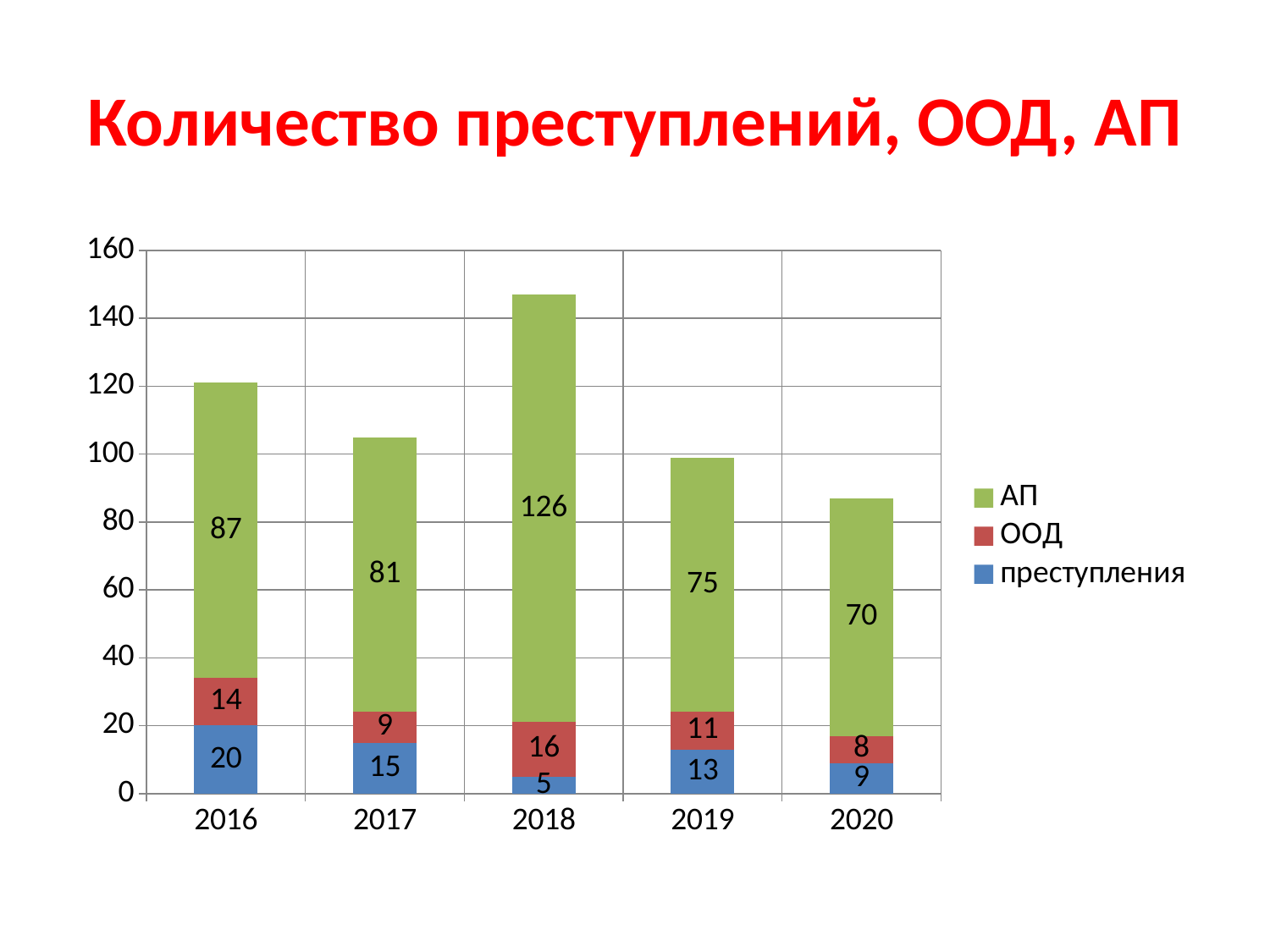
How many years are shown on the x axis? 5 What is the value of преступления for 2016? 20 What type of chart is shown on the slide? Stacked bar chart What is the difference between the АП values for 2016 and 2020? 17 What is the value of АП for 2018? 126 What is the value of ООД for 2019? 11 In which year is the АП value the highest? 2018 What is the total of the stacked bar for 2020? 87 Which is larger, the ООД value for 2016 or for 2017? 2016 How many series does the legend list? 3 What is the total of the stacked bar for 2018? 147 In which year is the преступления value the lowest? 2018